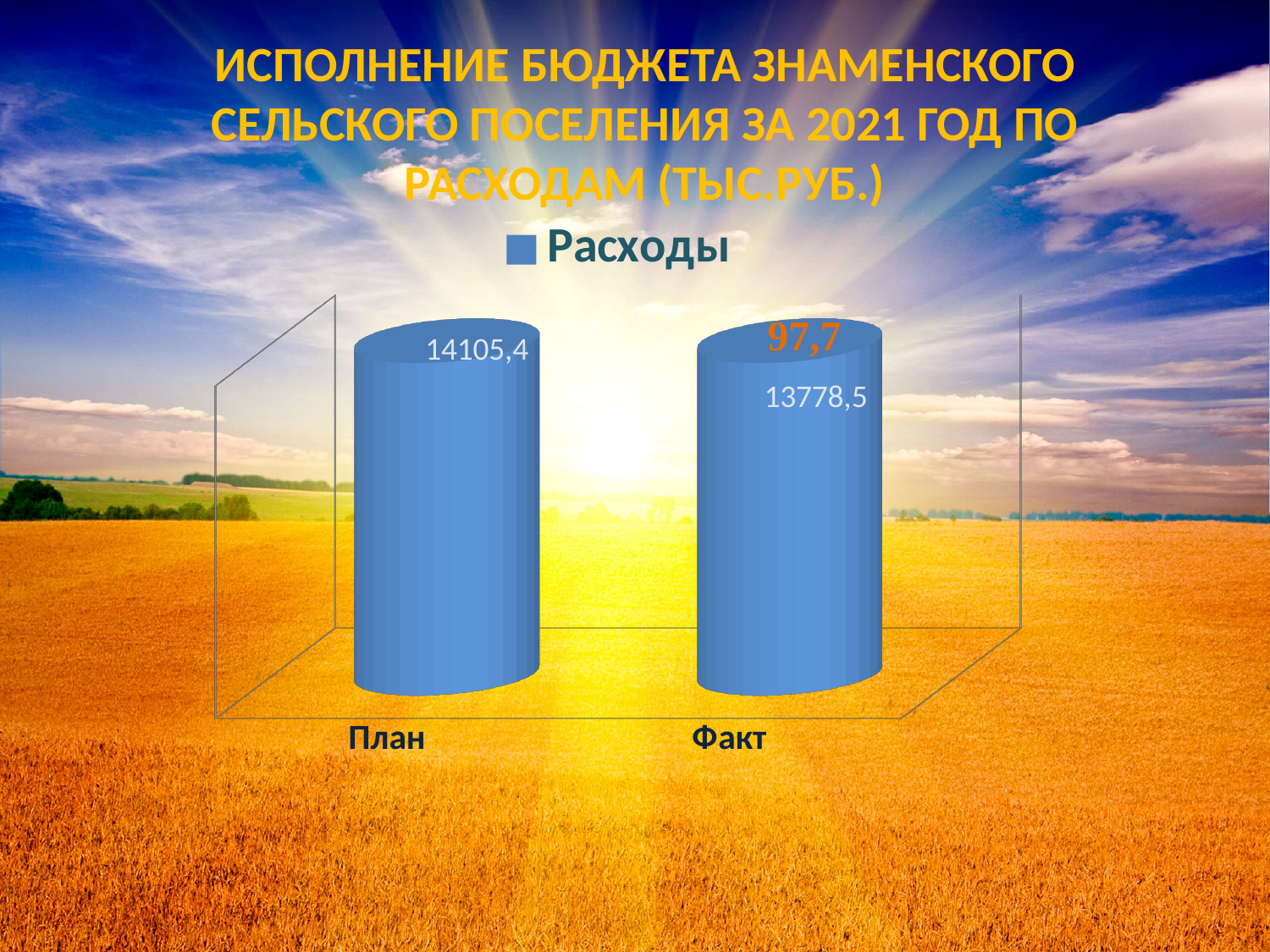
Is the value for Факт larger or smaller than the value for План? smaller What orange figure is printed above the Факт bar? 97,7 What kind of chart is shown on the slide? bar chart What is the value for Факт? 13778,5 Which category has the lowest value? Факт What is the difference between the План and Факт values? 326,9 What is the value for План? 14105,4 How many categories are shown on the x axis? 2 Which category has the higher value, План or Факт? План How many series does the legend list? 1 What is the name of the series shown in the legend? Расходы